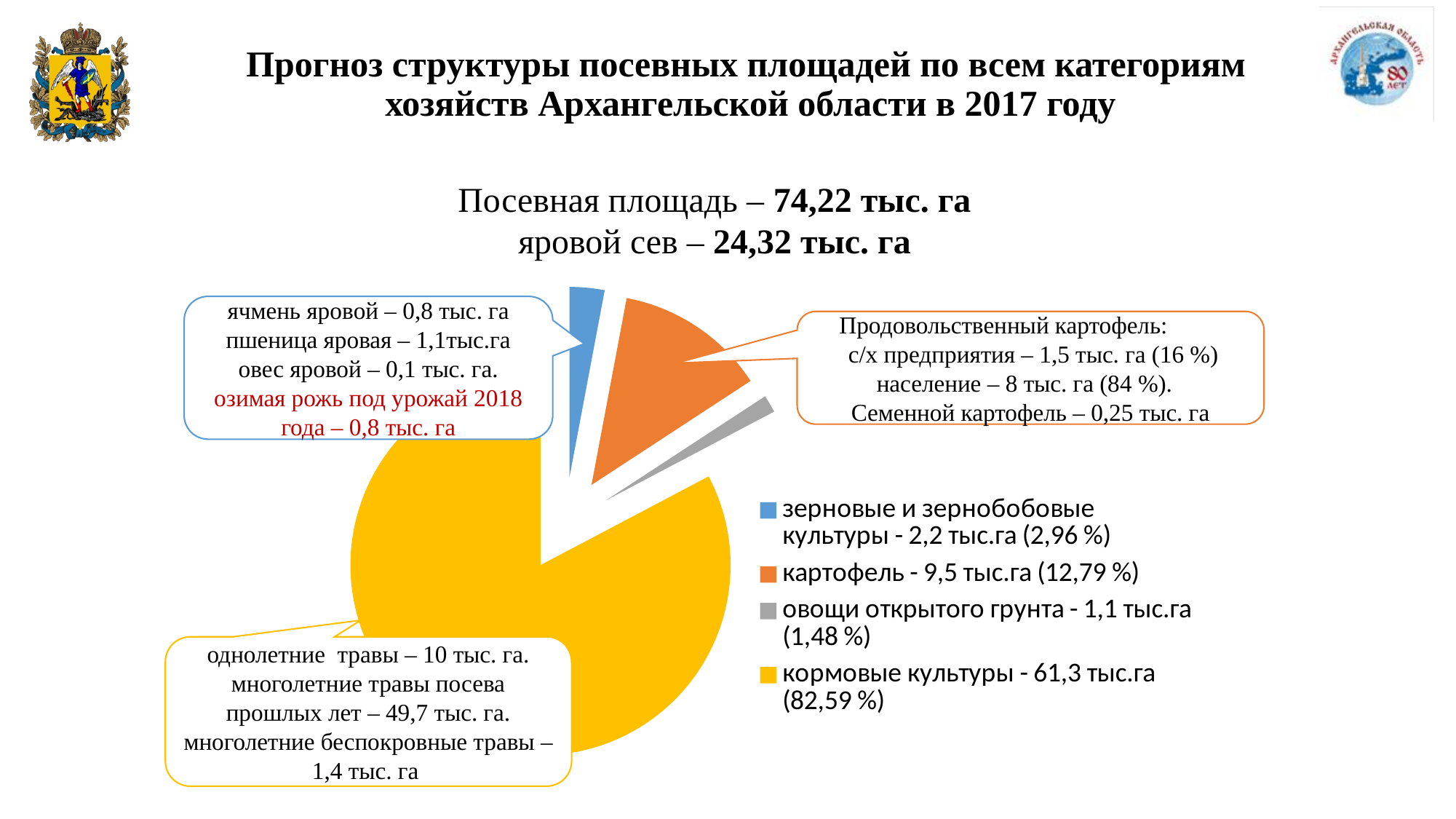
Which category has the smallest slice of the pie chart? овощи открытого грунта Which is larger in the pie chart: картофель or зерновые и зернобобовые культуры? картофель What is the difference between the values for кормовые культуры and картофель? 51,8 тыс.га What is the difference between the values for картофель and зерновые и зернобобовые культуры? 7,3 тыс.га What share of the pie does овощи открытого грунта represent? 1,48 % What share of the pie does кормовые культуры represent? 82,59 % How many slices does the pie chart have? 4 Which category has the largest slice of the pie chart? кормовые культуры What colour is the slice for кормовые культуры in the pie chart? yellow What is the value for зерновые и зернобобовые культуры in the pie chart? 2,2 тыс.га What kind of chart is shown on the slide? pie chart What is the value for картофель in the pie chart? 9,5 тыс.га